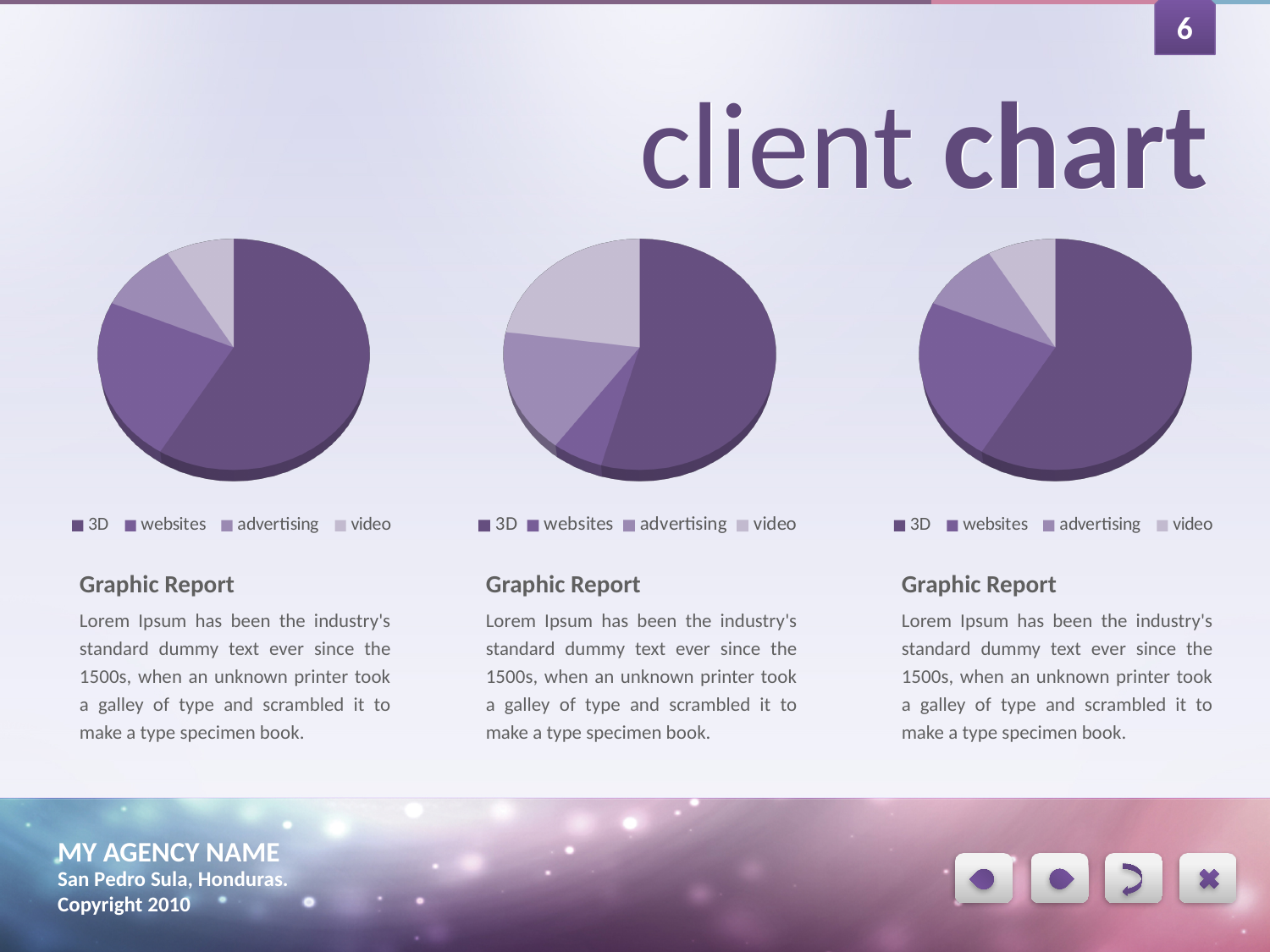
In the left pie chart, which category has the largest slice? 3D How many slices does the right pie chart have? 4 In the middle pie chart, which slice is larger, video or websites? video In the left pie chart, which slice is larger, 3D or websites? 3D How many series does the legend of the middle chart list? 4 In the middle pie chart, which category has the smallest slice? websites What kind of chart is the left chart on the slide? pie chart In the middle pie chart, which category has the largest slice? 3D In the right pie chart, which category has the largest slice? 3D How many pie charts are shown on the slide? 3 In the right pie chart, which slice is larger, websites or video? websites What are the four legend entries of the left chart? 3D, websites, advertising, video